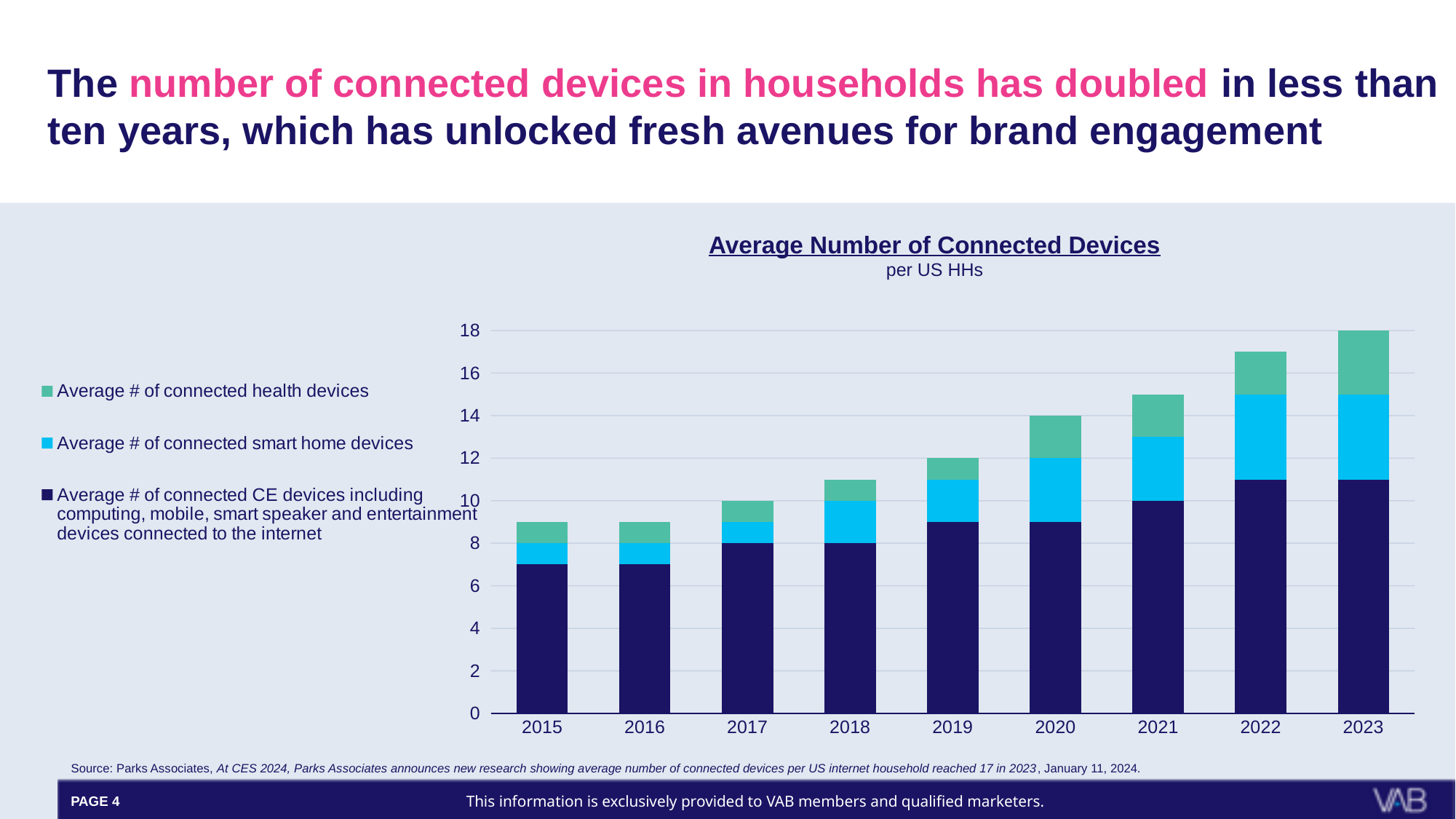
Is the average number of connected CE devices in 2023 greater or less than 10? greater Is the total bar height for 2015 greater or less than 10? less What is the title of the chart? Average Number of Connected Devices Is the total bar height for 2023 greater or less than 16? greater How many series does the legend list? 3 How many years are shown on the x axis of the chart? 9 Do the total bar heights generally rise or fall from 2015 to 2023? Rise What kind of chart is shown on the slide? Stacked bar chart Which year has the tallest stacked bar? 2023 Which colour represents the average number of connected health devices in the chart? Green Which is taller, the total bar for 2017 or the total bar for 2021? 2021